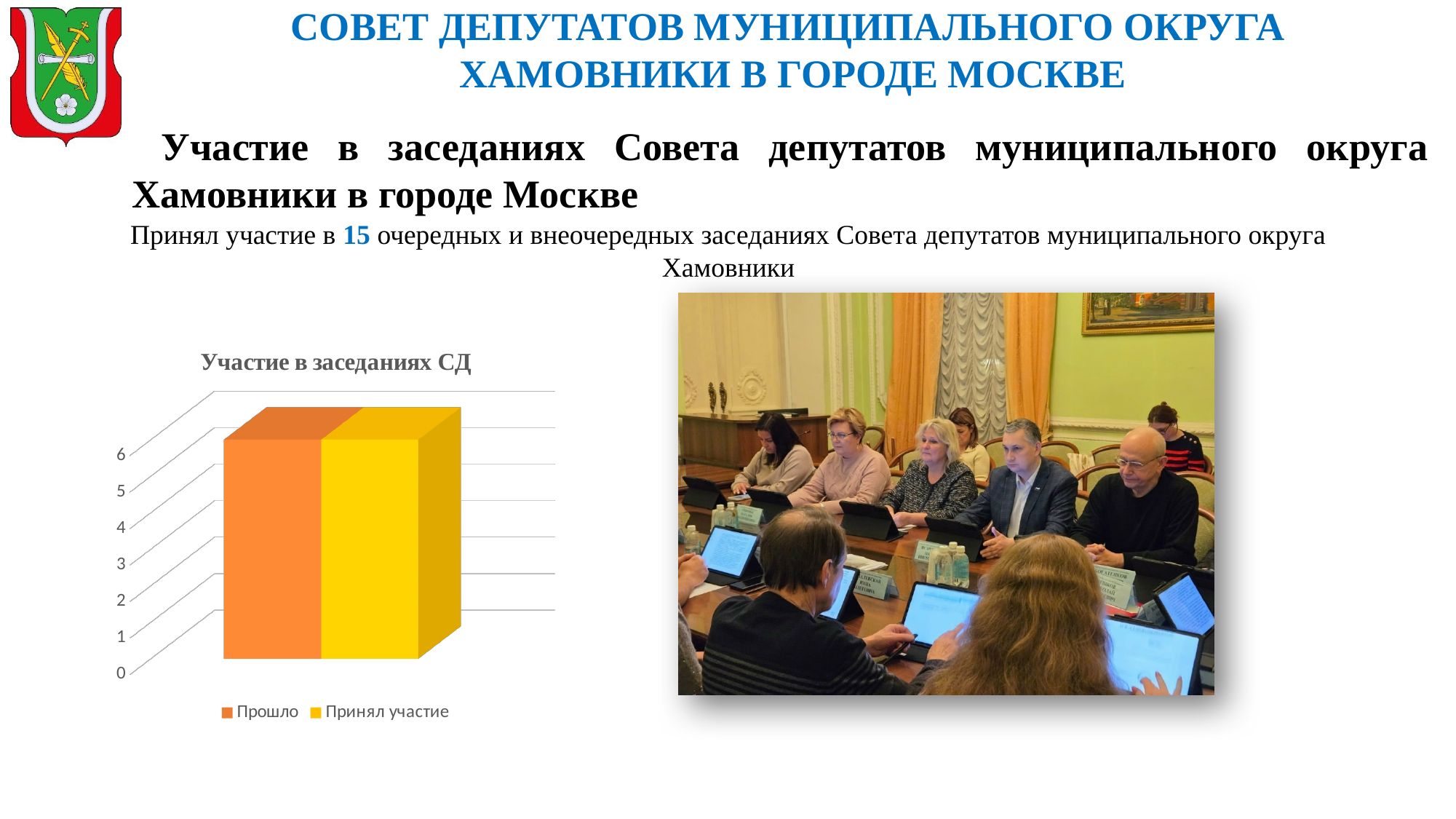
What is the highest tick value shown on the vertical axis of the chart? 6 Which colour represents the series "Прошло" in the chart? orange What kind of chart is shown on the slide? bar chart Is the value for "Принял участие" greater or less than 2? greater Is the value for "Прошло" greater or less than 3? greater Is the value for "Принял участие" greater or less than 5? greater How many series does the legend of the chart list? 2 What is the title of the chart on the slide? Участие в заседаниях СД